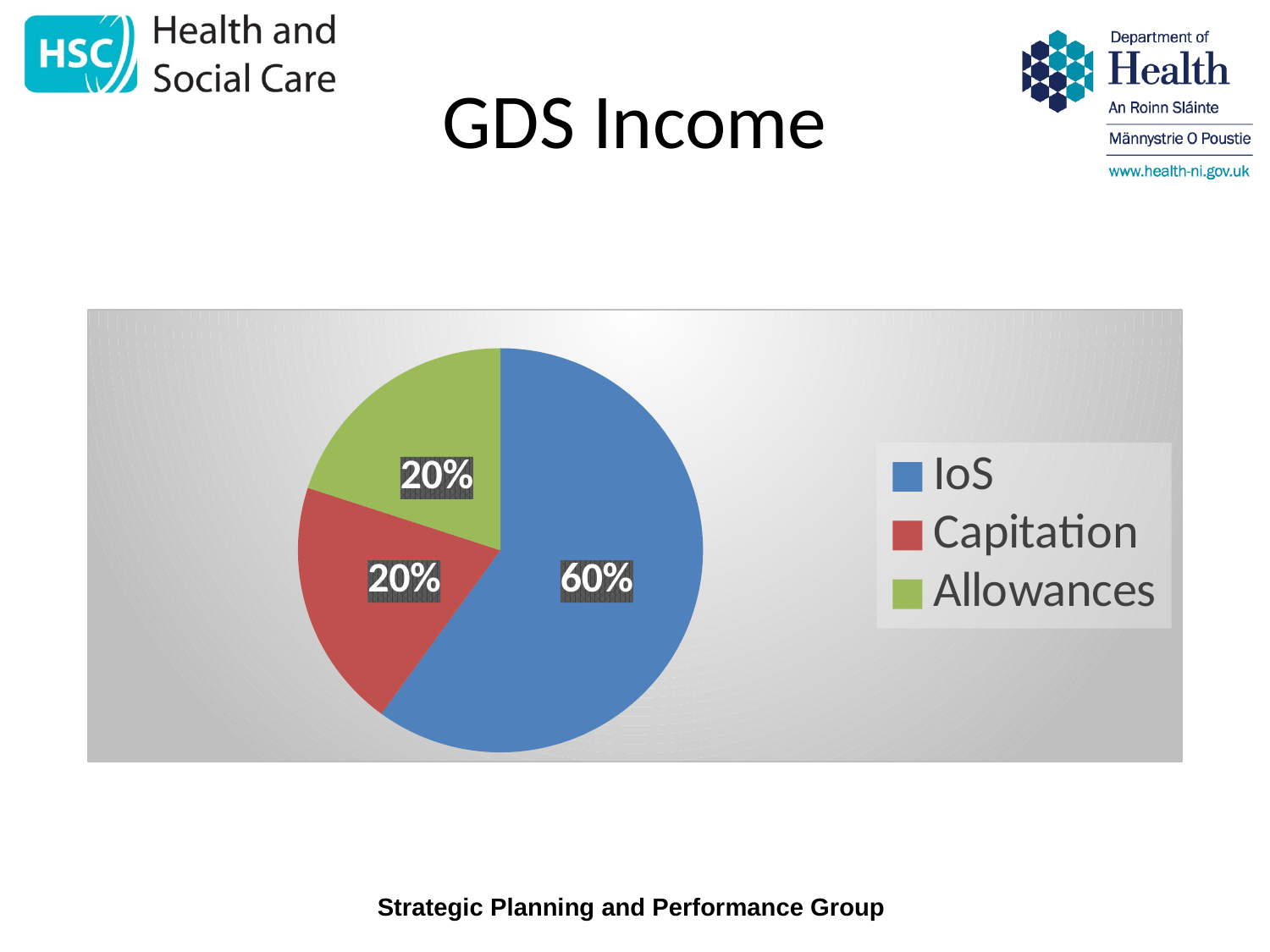
Is the share for IoS greater or less than 50%? greater What kind of chart is shown on the slide? pie chart What colour is the Capitation slice in the pie chart? red What share of GDS Income does Allowances account for? 20% Which is larger, the IoS share or the Allowances share? IoS What share of GDS Income does IoS account for? 60% How many categories does the legend list? 3 How many slices does the pie chart have? 3 What is the difference in percentage points between the IoS share and the Capitation share? 40 What is the title of the slide containing the pie chart? GDS Income Which category has the largest share of the pie? IoS What share of GDS Income does Capitation account for? 20%